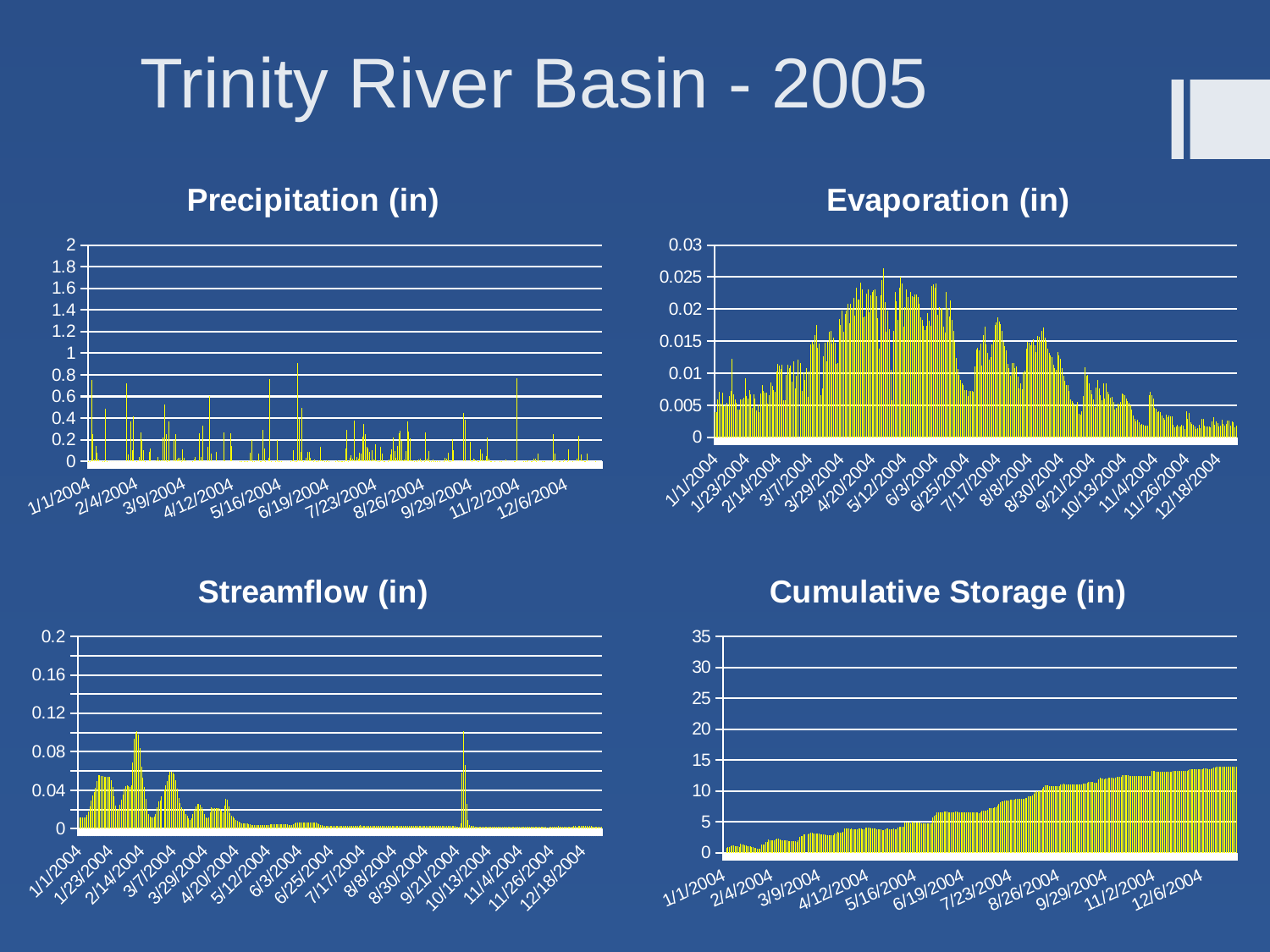
On the Cumulative Storage (in) chart, do the values generally rise or fall from left to right along the x axis? rise On the Cumulative Storage (in) chart, is the value at 12/6/2004 greater or less than 10? greater On the Evaporation (in) chart, is the highest value greater or less than 0.02? greater On the Cumulative Storage (in) chart, is the value at 7/23/2004 greater or less than 5? greater What kind of chart is the Precipitation (in) chart? bar chart How many charts are shown on the slide? 4 On the Evaporation (in) chart, do the values generally rise or fall from 9/21/2004 to 12/18/2004? fall What kind of chart is the Cumulative Storage (in) chart? bar chart What is the title of the top-right chart? Evaporation (in)